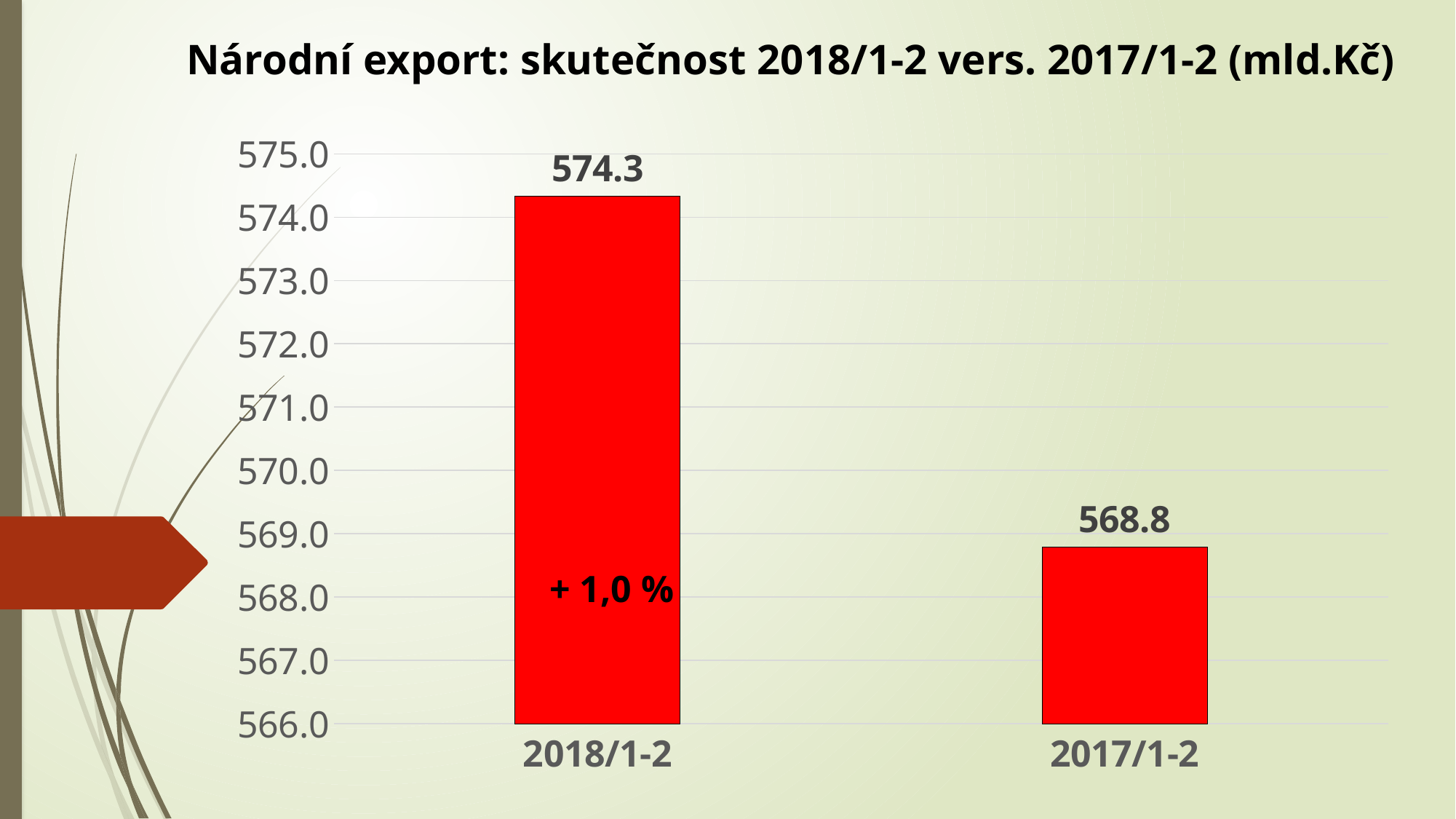
Is the value for 2017/1-2 greater or less than 570.0? less Which category has the lowest value? 2017/1-2 What is the value for 2018/1-2? 574.3 Is the value for 2018/1-2 greater or less than 574.0? greater Which is larger, the value for 2018/1-2 or the value for 2017/1-2? 2018/1-2 What is the title of the chart? Národní export: skutečnost 2018/1-2 vers. 2017/1-2 (mld.Kč) What is the value for 2017/1-2? 568.8 How many categories are shown on the x axis? 2 What percentage change is printed on the 2018/1-2 bar? + 1,0 % What is the difference between the values for 2018/1-2 and 2017/1-2? 5.5 What kind of chart is shown on the slide? bar chart Which category has the highest value? 2018/1-2